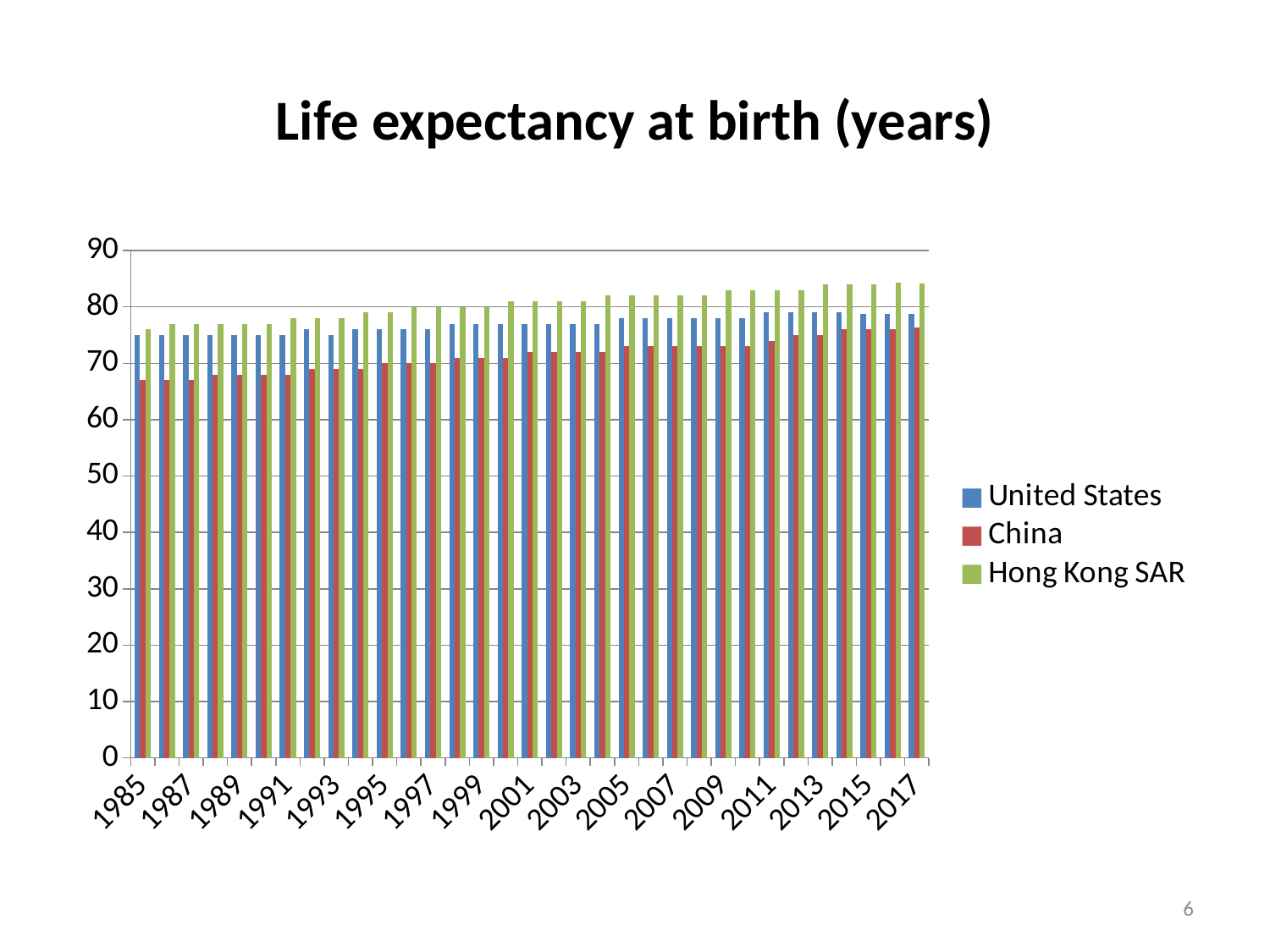
Do the values for China rise or fall from 1985 to 2017? rise Is the value for United States in 1985 greater or less than 70? greater What is the title of the chart? Life expectancy at birth (years) Which is larger in 1985, the value for United States or the value for China? United States What kind of chart is shown on the slide? Bar chart What is the first year shown on the x axis? 1985 Is the value for Hong Kong SAR in 2017 greater or less than 80? greater How many series does the legend list? 3 Is the value for China in 1985 greater or less than 70? less Which series has the highest value in 2017? Hong Kong SAR Which series does the legend list first? United States Which series has the lowest value in 1985? China